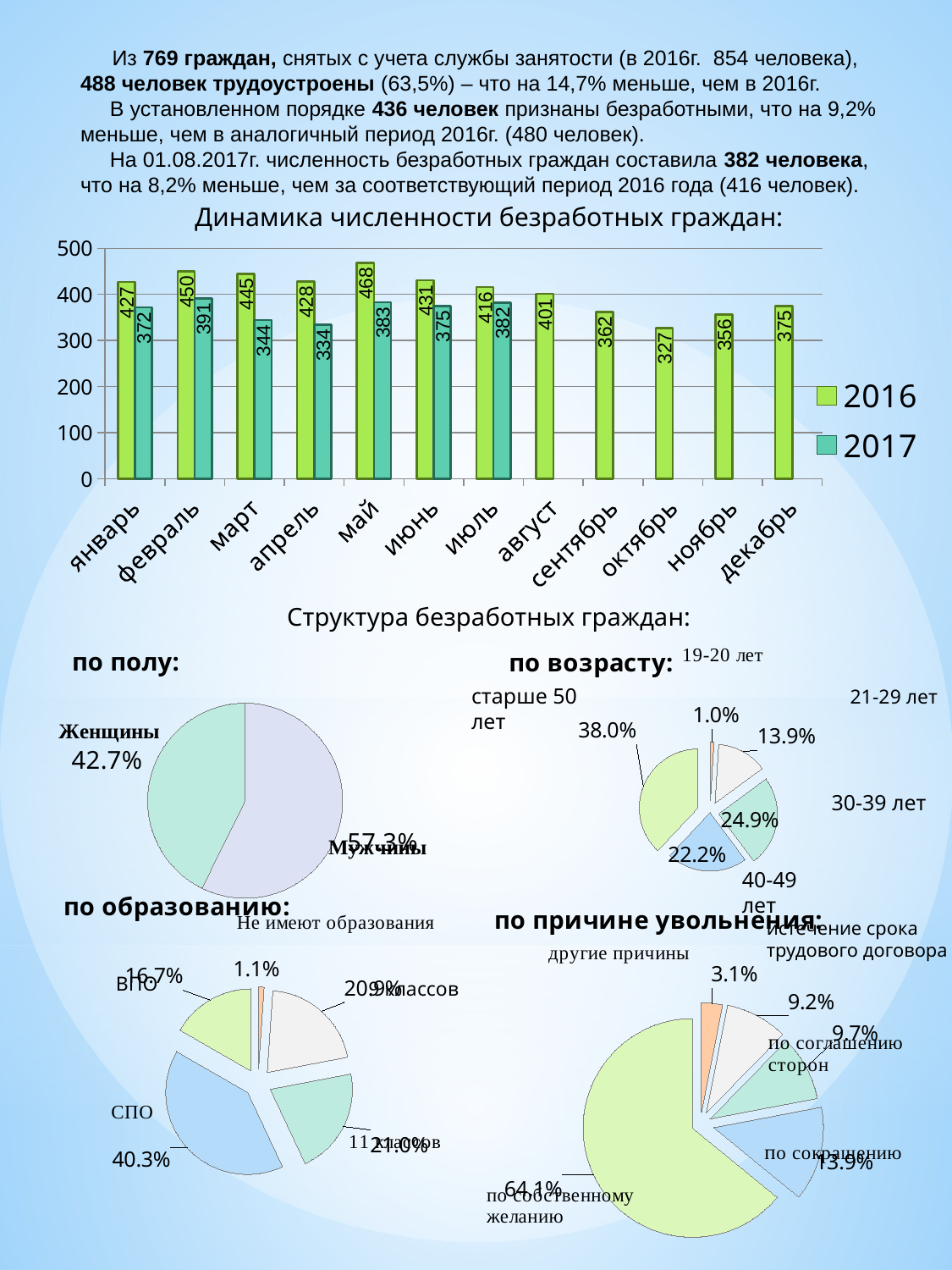
In the chart 'Динамика численности безработных граждан', how many series does the legend list? 2 In the chart 'Динамика численности безработных граждан', what is the value for май in the 2016 series? 468 In the chart 'Динамика численности безработных граждан', what is the difference between the 2016 and 2017 values for март? 101 What kind of chart is 'Динамика численности безработных граждан'? bar chart In the pie chart 'по причине увольнения', which is larger: по сокращению or по соглашению сторон? по сокращению In the chart 'Динамика численности безработных граждан', what is the value for февраль in the 2017 series? 391 In the chart 'Динамика численности безработных граждан', how many months have a value plotted for the 2017 series? 7 In the pie chart 'по полу', what share is Женщины? 42.7% In the pie chart 'по возрасту', which age group has the largest share? старше 50 лет In the pie chart 'по причине увольнения', what share is по собственному желанию? 64.1% In the chart 'Динамика численности безработных граждан', which month has the lowest value in the 2016 series? октябрь In the pie chart 'по образованию', what share is СПО? 40.3%